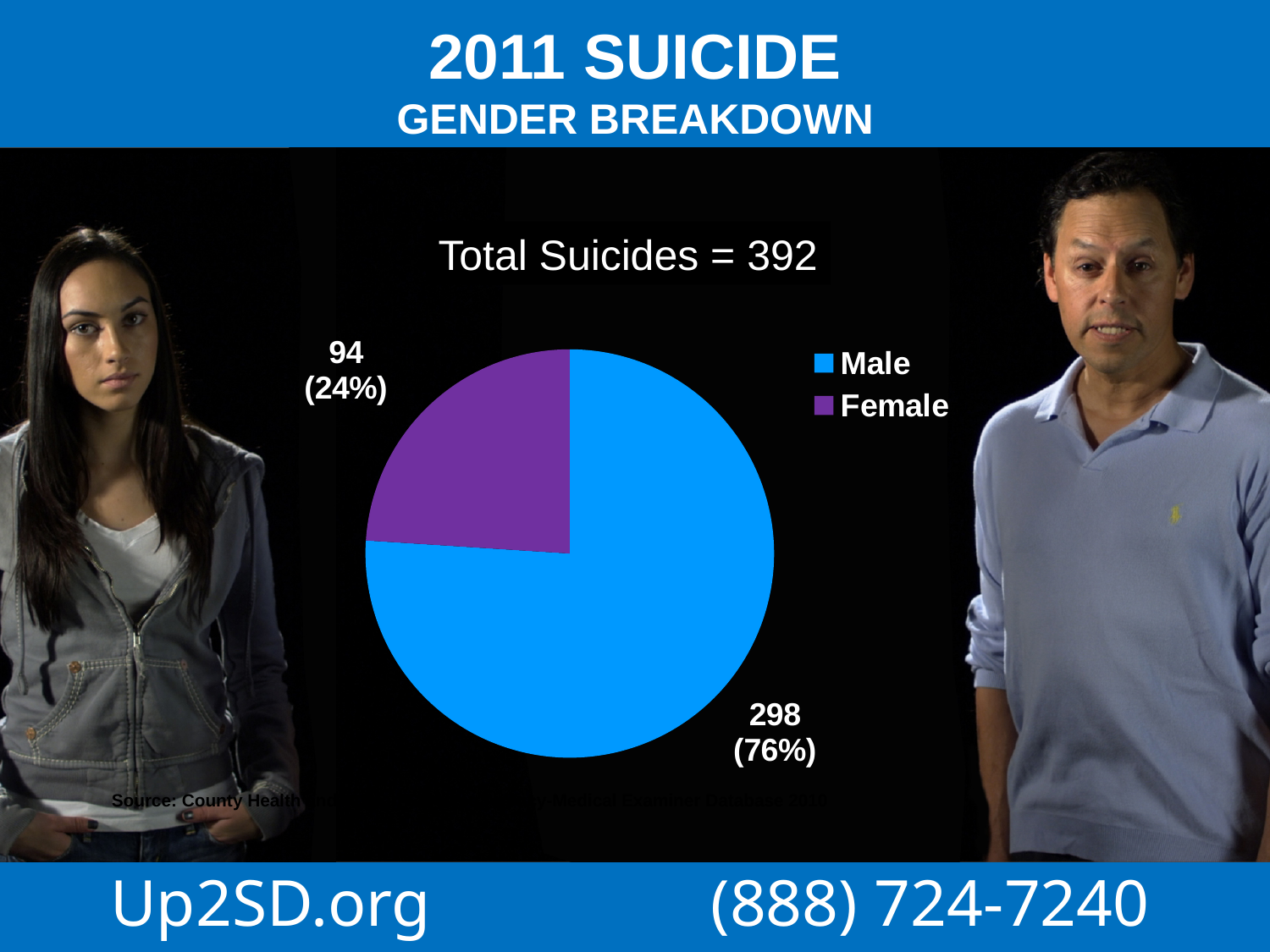
Is the Male count larger or smaller than the Female count? larger How many suicides are shown for Male? 298 How many categories does the pie chart have? 2 What colour is the Female slice of the pie? purple How many suicides are shown for Female? 94 What percentage of the pie does the Female slice represent? 24% Which gender has the smaller slice of the pie? Female What is the total number of suicides shown on the slide? 392 Which gender has the larger slice of the pie? Male What kind of chart is shown on the slide? pie chart What is the difference between the Male and Female suicide counts? 204 What percentage of the pie does the Male slice represent? 76%